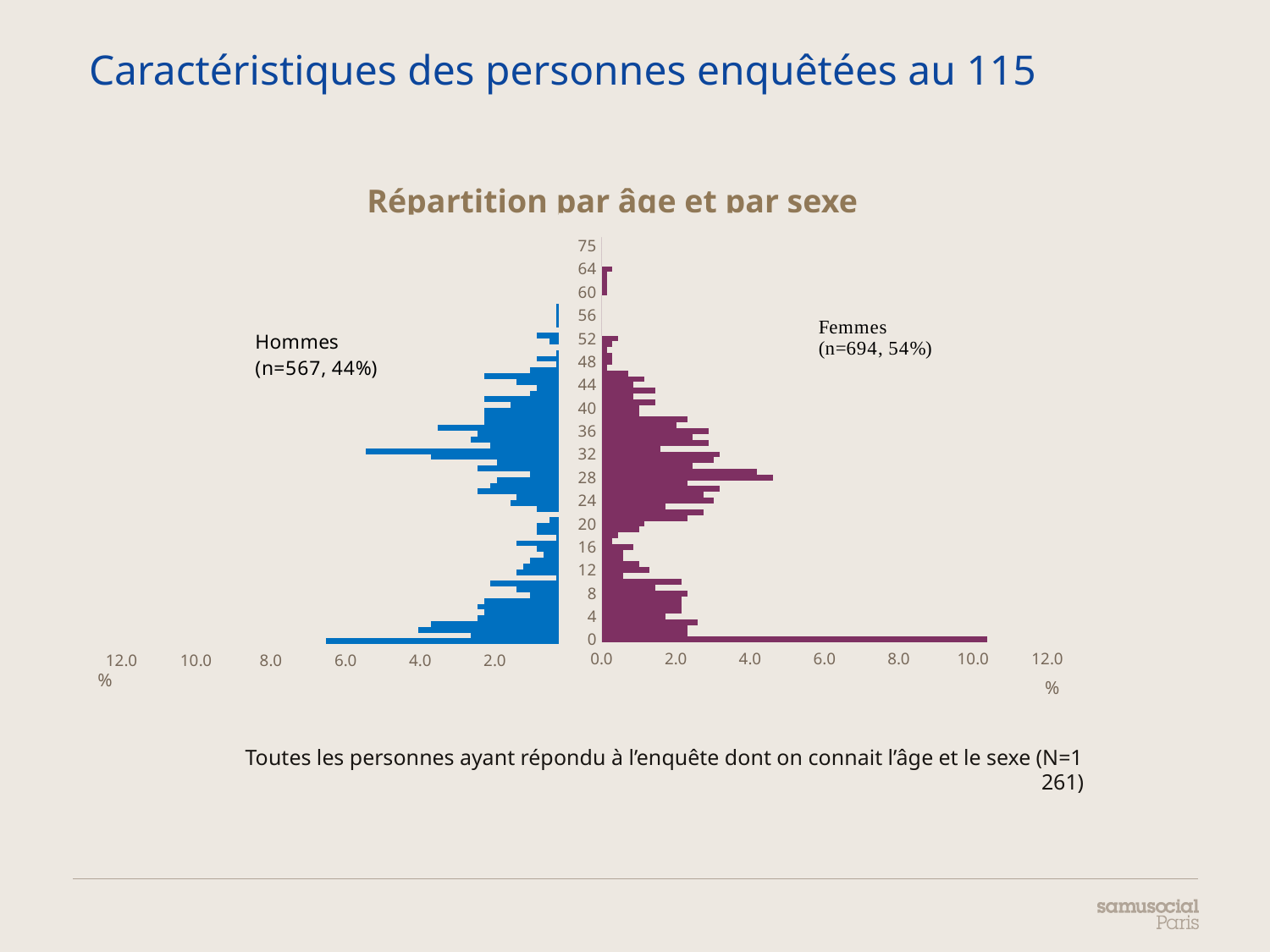
What kind of chart is shown on the slide? bar chart At age 0, which group has the larger value, Hommes or Femmes? Femmes Is the Femmes value for age 28 greater or less than 6.0? less What is the title of the chart? Répartition par âge et par sexe Is the Femmes value for age 28 greater or less than 4.0? greater What sample size and share are given for Hommes? n=567, 44% Which age has the longest Femmes bar? 0 How many groups (series) does the chart show? 2 Which age has the longest Hommes bar? 0 Is the Hommes value for age 0 greater or less than 4.0? greater